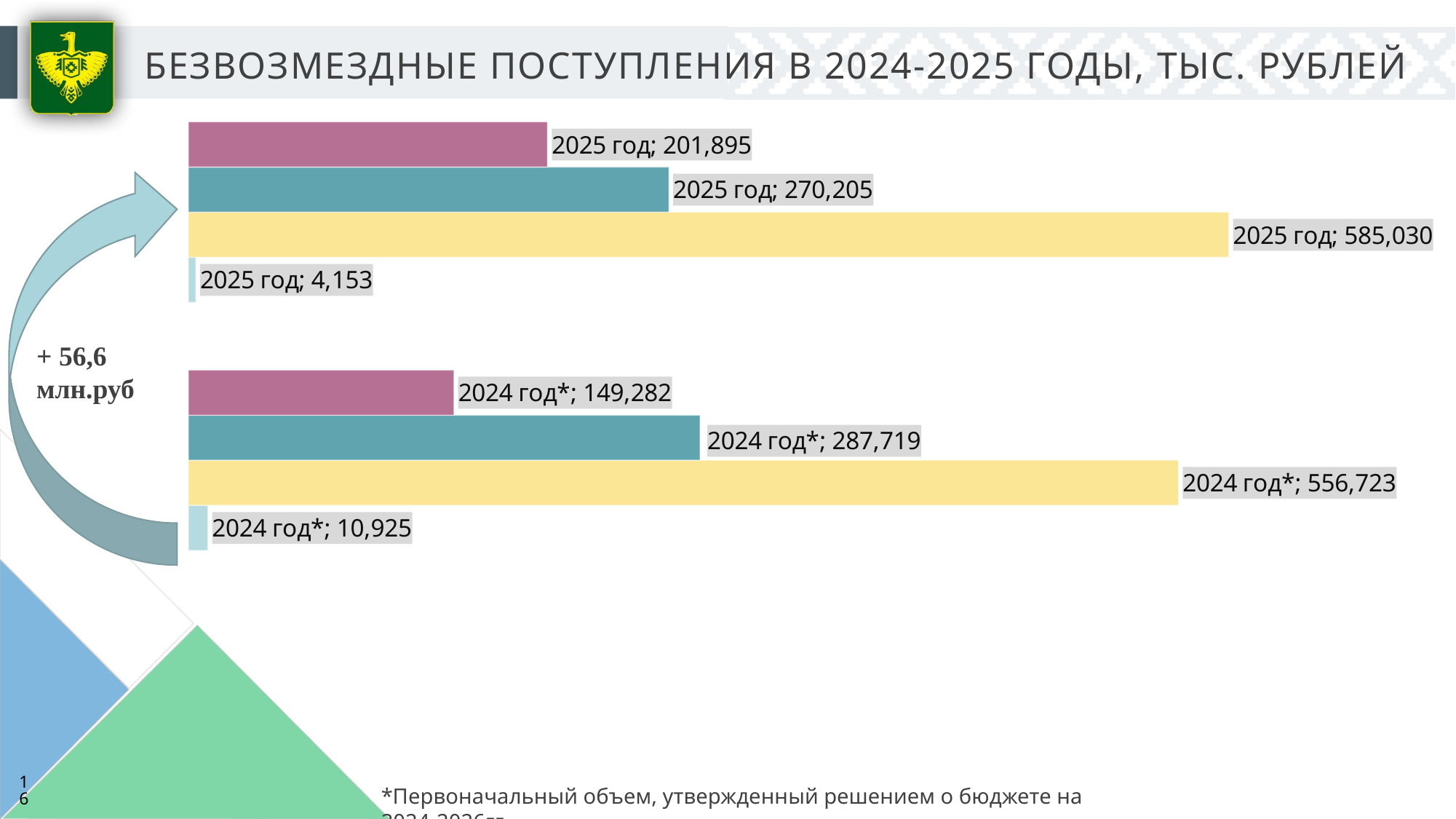
How many bars are plotted on the chart? 8 What is the difference between the purple bar for 2025 год and the purple bar for 2024 год*? 52,613 What is the value of the purple bar for 2024 год*? 149,282 Which is larger: the teal bar for 2025 год or the teal bar for 2024 год*? 2024 год* What is the value of the light blue bar for 2024 год*? 10,925 What is the title of the slide? БЕЗВОЗМЕЗДНЫЕ ПОСТУПЛЕНИЯ В 2024-2025 ГОДЫ, ТЫС. РУБЛЕЙ What is the value of the yellow bar for 2025 год? 585,030 What is the difference between the yellow bar for 2025 год and the yellow bar for 2024 год*? 28,307 Which bar has the lowest value on the chart? 2025 год; 4,153 What is the value of the teal bar for 2025 год? 270,205 What type of chart is shown on the slide? bar chart Which bar has the highest value on the chart? 2025 год; 585,030